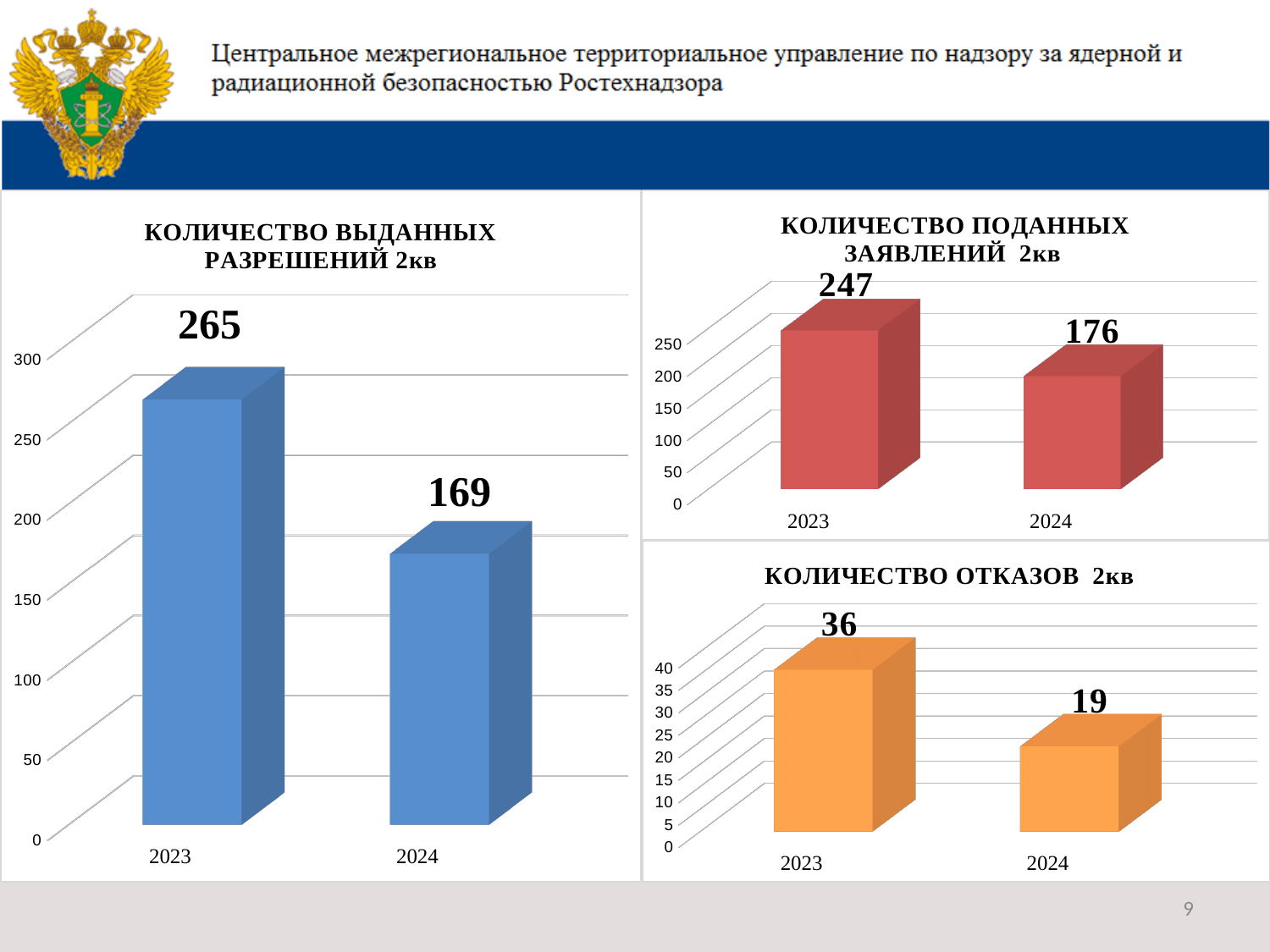
What kind of chart is the chart titled 'КОЛИЧЕСТВО ОТКАЗОВ 2кв'? bar chart In the chart titled 'КОЛИЧЕСТВО ОТКАЗОВ 2кв', which year has the lowest value? 2024 In the chart titled 'КОЛИЧЕСТВО ПОДАННЫХ ЗАЯВЛЕНИЙ 2кв', what is the value for 2024? 176 In the chart titled 'КОЛИЧЕСТВО ВЫДАННЫХ РАЗРЕШЕНИЙ 2кв', what is the difference between the 2023 and 2024 values? 96 In the chart titled 'КОЛИЧЕСТВО ОТКАЗОВ 2кв', what is the value for 2023? 36 In the chart titled 'КОЛИЧЕСТВО ВЫДАННЫХ РАЗРЕШЕНИЙ 2кв', do the values rise or fall from 2023 to 2024? fall In the chart titled 'КОЛИЧЕСТВО ОТКАЗОВ 2кв', what is the difference between the 2023 and 2024 values? 17 In the chart titled 'КОЛИЧЕСТВО ВЫДАННЫХ РАЗРЕШЕНИЙ 2кв', what is the value for 2024? 169 In the chart titled 'КОЛИЧЕСТВО ПОДАННЫХ ЗАЯВЛЕНИЙ 2кв', which year has the higher value? 2023 In the chart titled 'КОЛИЧЕСТВО ОТКАЗОВ 2кв', what is the value for 2024? 19 In the chart titled 'КОЛИЧЕСТВО ПОДАННЫХ ЗАЯВЛЕНИЙ 2кв', what is the value for 2023? 247 In the chart titled 'КОЛИЧЕСТВО ВЫДАННЫХ РАЗРЕШЕНИЙ 2кв', what is the value for 2023? 265